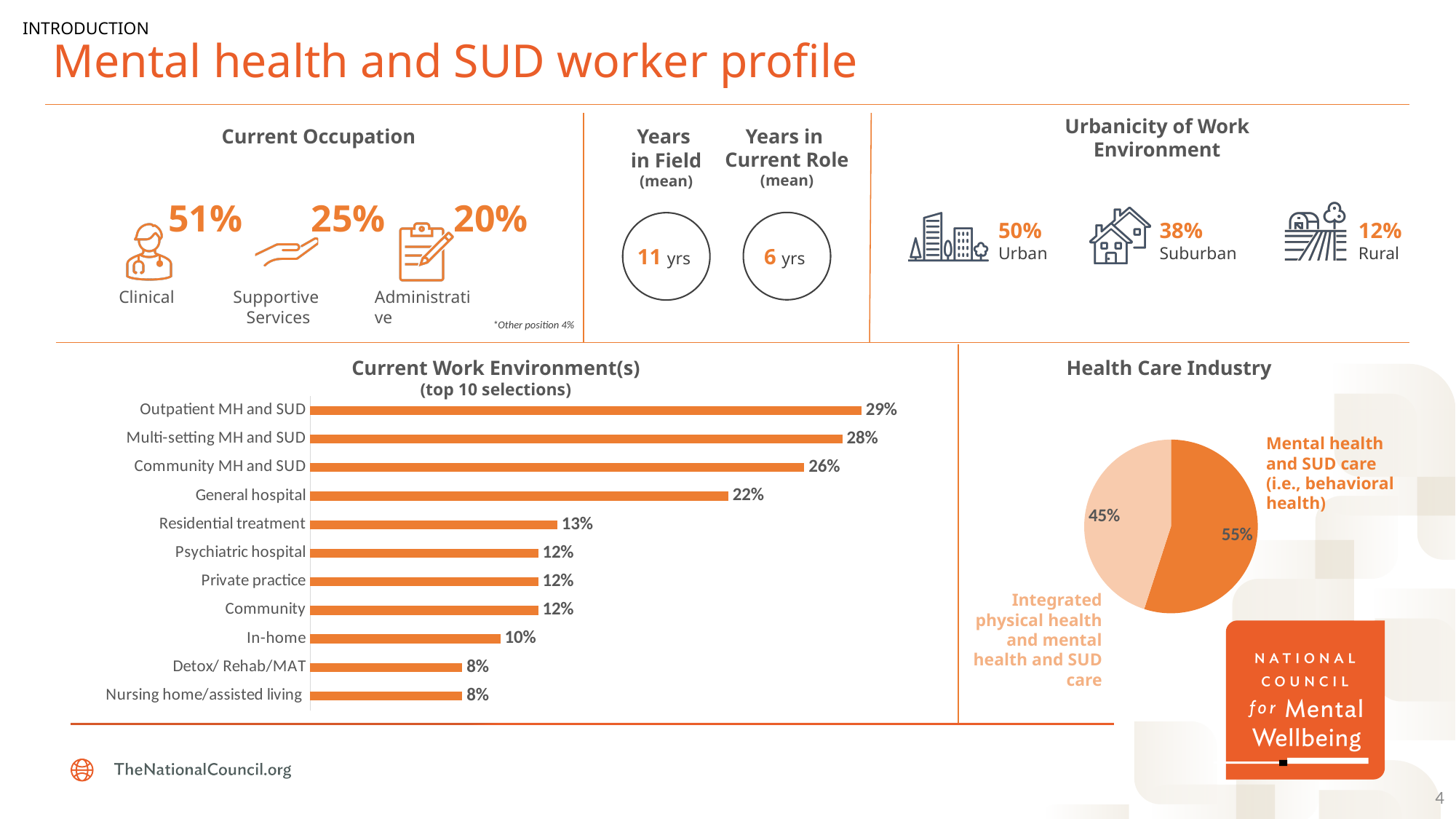
In the Current Work Environment(s) chart, what is the value for Outpatient MH and SUD? 29% What kind of chart is the Health Care Industry chart? Pie chart In the Health Care Industry chart, which slice is larger, Mental health and SUD care or Integrated physical health and mental health and SUD care? Mental health and SUD care In the Current Work Environment(s) chart, what is the value for General hospital? 22% In the Health Care Industry chart, what share of the pie is Mental health and SUD care (i.e., behavioral health)? 55% What kind of chart is the Current Work Environment(s) chart? Bar chart In the Health Care Industry chart, what is the value for Integrated physical health and mental health and SUD care? 45% In the Current Work Environment(s) chart, what is the value for In-home? 10% In the Current Work Environment(s) chart, which is larger, Multi-setting MH and SUD or General hospital? Multi-setting MH and SUD In the Current Work Environment(s) chart, what is the difference between Community MH and SUD and Residential treatment? 13% In the Current Work Environment(s) chart, which category has the highest value? Outpatient MH and SUD How many categories are plotted in the Current Work Environment(s) chart? 11